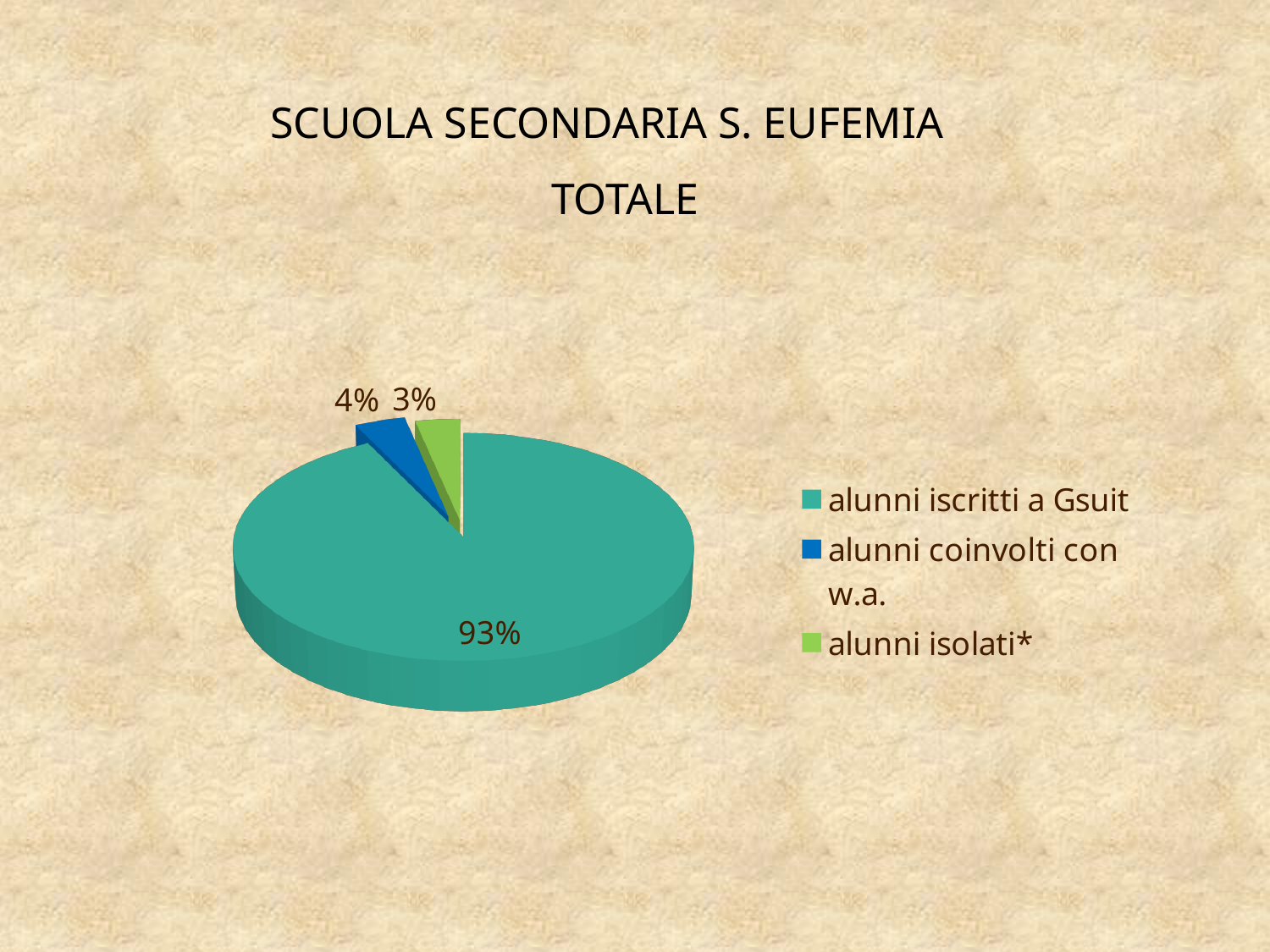
What is the difference in percentage points between 'alunni iscritti a Gsuit' and 'alunni coinvolti con w.a.'? 89 What kind of chart is shown on the slide? pie chart How many categories does the pie chart show? 3 What colour is the slice for 'alunni isolati*'? green Which category has the smallest slice of the pie? alunni isolati* Which is larger, the slice for 'alunni coinvolti con w.a.' or the slice for 'alunni isolati*'? alunni coinvolti con w.a. What share of the pie is 'alunni isolati*'? 3% What share of the pie is 'alunni coinvolti con w.a.'? 4% What is the difference in percentage points between 'alunni coinvolti con w.a.' and 'alunni isolati*'? 1 What share of the pie is 'alunni iscritti a Gsuit'? 93% Which category has the largest slice of the pie? alunni iscritti a Gsuit What is the title of the chart? SCUOLA SECONDARIA S. EUFEMIA TOTALE